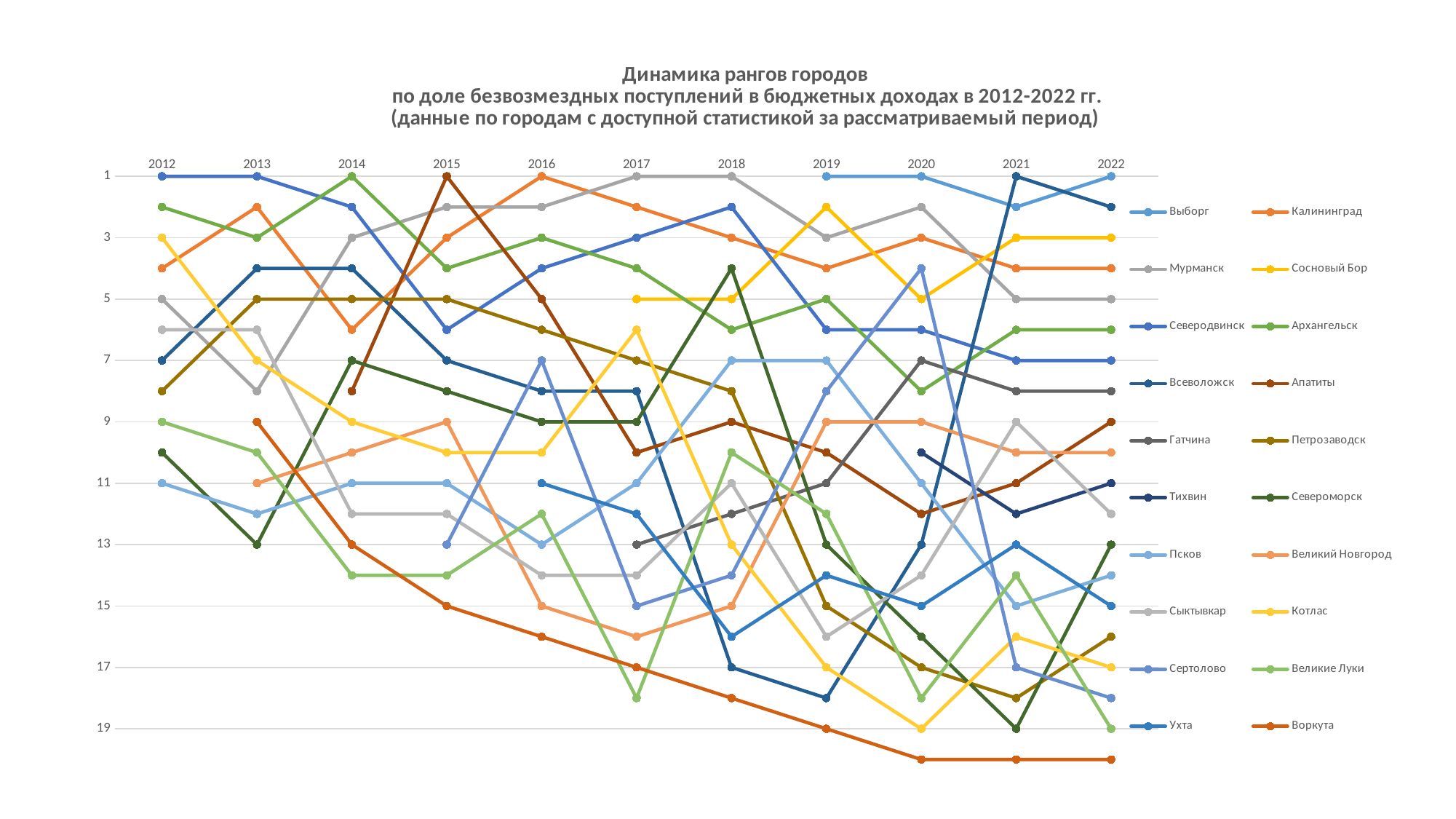
How many years are plotted along the x axis? 11 What rank does Котлас hold in 2020? 19 What rank does Мурманск hold in 2021? 5 How many cities (series) does the legend list? 20 What rank does Сосновый Бор hold in 2022? 3 What rank does Апатиты hold in 2015? 1 Is the rank number for Воркута in 2022 greater or less than 19? greater Which city has the largest rank number (lowest position) in 2022? Воркута Does the rank number for Воркута increase or decrease from 2013 to 2022? increase What rank does Выборг hold in 2022? 1 Which city is ranked 1 in 2016? Калининград What kind of chart is shown on the slide? line chart